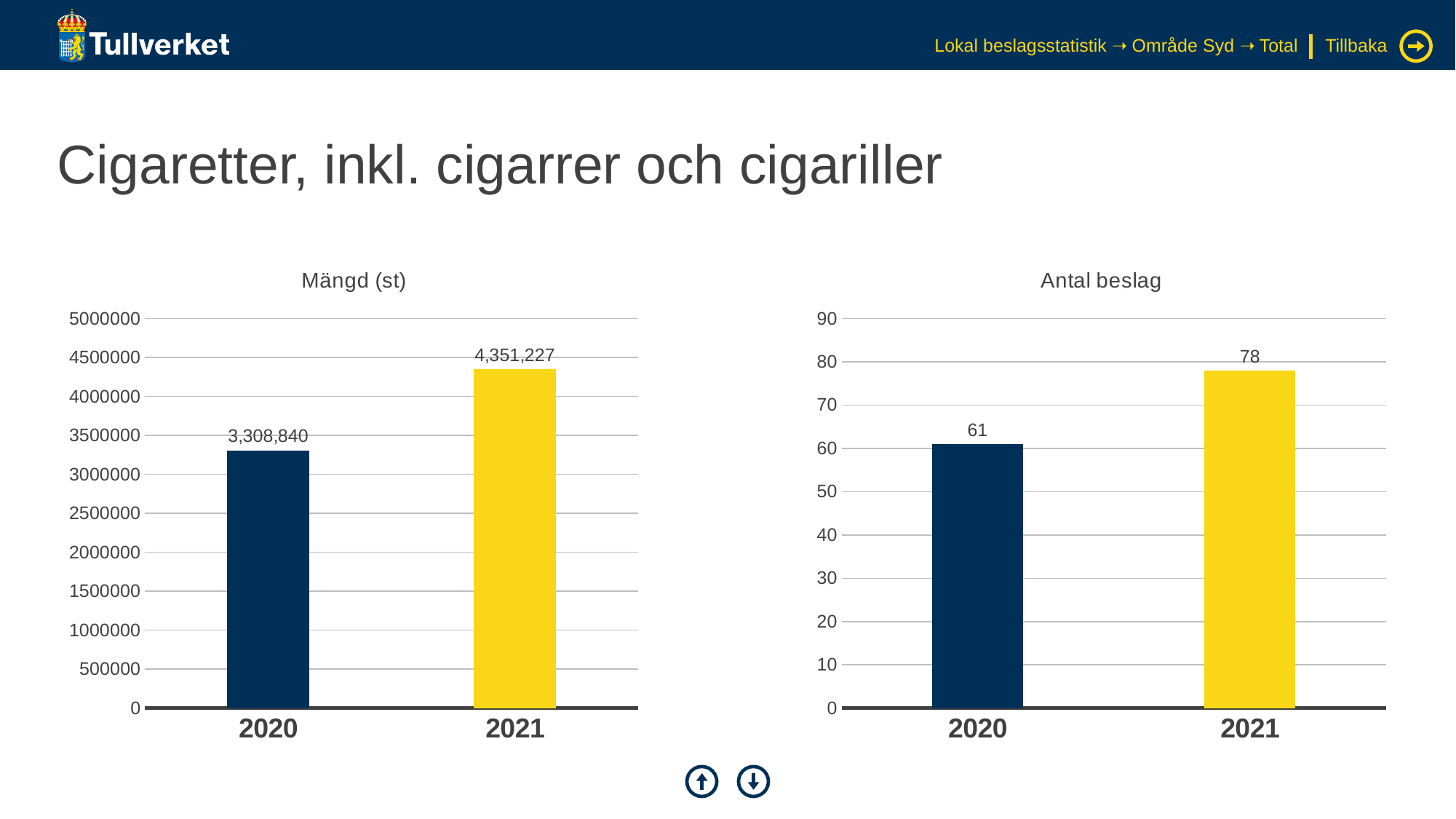
In the 'Mängd (st)' chart, what is the difference between the values for 2021 and 2020? 1,042,387 In the 'Mängd (st)' chart, is the value for 2020 greater or less than 3000000? greater In the 'Mängd (st)' chart, what is the value for 2021? 4,351,227 In the 'Antal beslag' chart, what is the difference between the values for 2021 and 2020? 17 What kind of chart is the 'Antal beslag' chart? bar chart In the 'Antal beslag' chart, what is the value for 2020? 61 In the 'Antal beslag' chart, what is the value for 2021? 78 In the 'Antal beslag' chart, which year has the lowest value? 2020 In the 'Mängd (st)' chart, which year has the highest value? 2021 In the 'Mängd (st)' chart, do the values rise or fall from 2020 to 2021? rise In the 'Antal beslag' chart, how many years are shown on the x axis? 2 In the 'Mängd (st)' chart, what is the value for 2020? 3,308,840